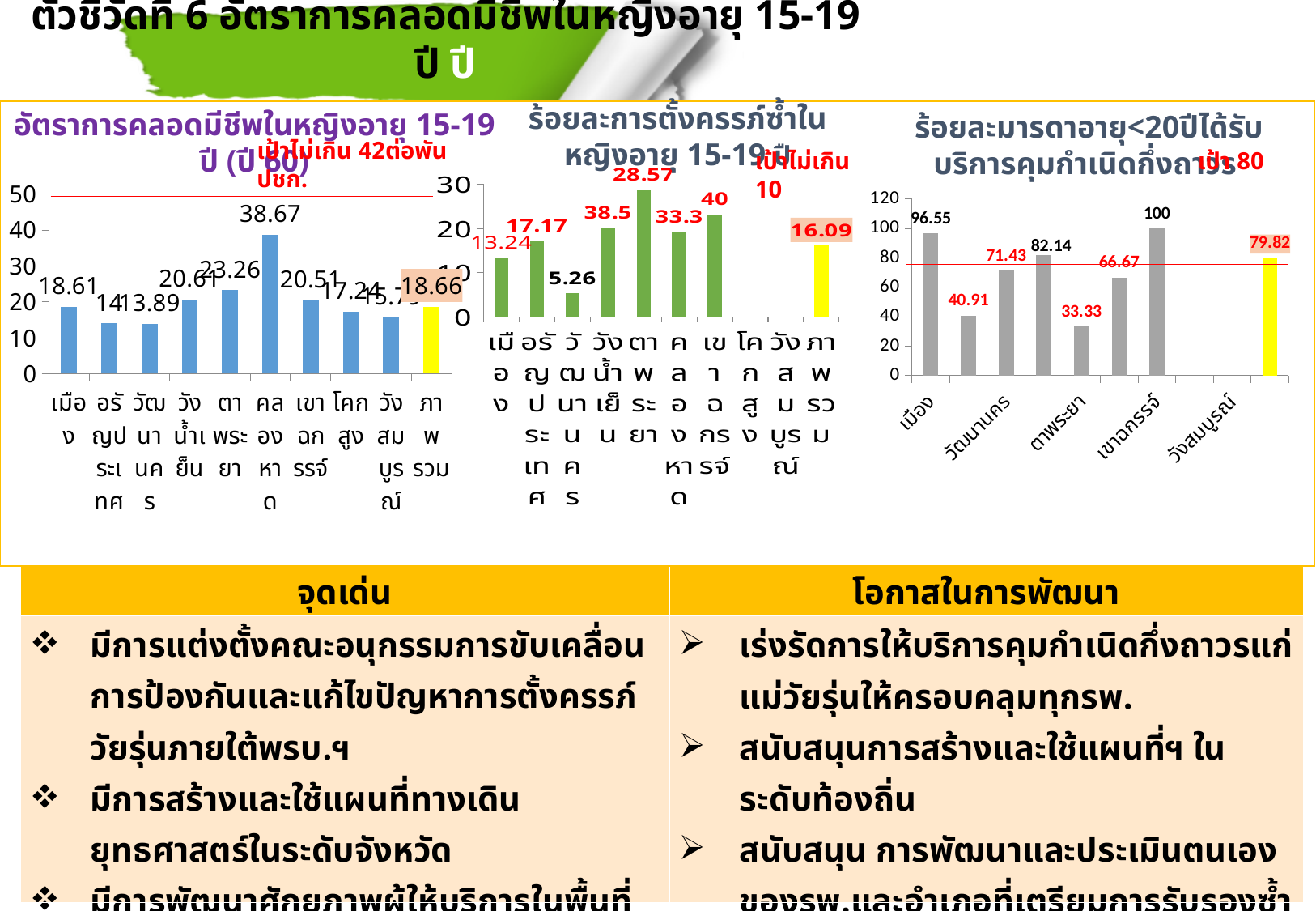
In the left chart (อัตราการคลอดมีชีพในหญิงอายุ 15-19 ปี), what is the difference between คลองหาด and เมือง? 20.06 In the right chart (ร้อยละมารดาอายุ<20ปีได้รับบริการคุมกำเนิดกึ่งถาวร), is the value for ตาพระยา greater or less than 40? less In the middle chart (ร้อยละการตั้งครรภ์ซ้ำในหญิงอายุ 15-19 ปี), what is the value for วัฒนานคร? 5.26 What kind of chart is the middle chart (ร้อยละการตั้งครรภ์ซ้ำในหญิงอายุ 15-19 ปี)? bar chart In the left chart (อัตราการคลอดมีชีพในหญิงอายุ 15-19 ปี), which is larger, เขาฉกรรจ์ or โคกสูง? เขาฉกรรจ์ In the left chart (อัตราการคลอดมีชีพในหญิงอายุ 15-19 ปี), what is the value for คลองหาด? 38.67 In the middle chart (ร้อยละการตั้งครรภ์ซ้ำในหญิงอายุ 15-19 ปี), what is the value for ภาพรวม? 16.09 In the left chart (อัตราการคลอดมีชีพในหญิงอายุ 15-19 ปี), what is the value for ภาพรวม? 18.66 In the right chart (ร้อยละมารดาอายุ<20ปีได้รับบริการคุมกำเนิดกึ่งถาวร), what is the difference between เขาฉกรรจ์ and ตาพระยา? 66.67 In the left chart (อัตราการคลอดมีชีพในหญิงอายุ 15-19 ปี), which category has the highest value? คลองหาด In the left chart (อัตราการคลอดมีชีพในหญิงอายุ 15-19 ปี), how many categories are shown on the x axis? 10 In the right chart (ร้อยละมารดาอายุ<20ปีได้รับบริการคุมกำเนิดกึ่งถาวร), what is the value for เขาฉกรรจ์? 100